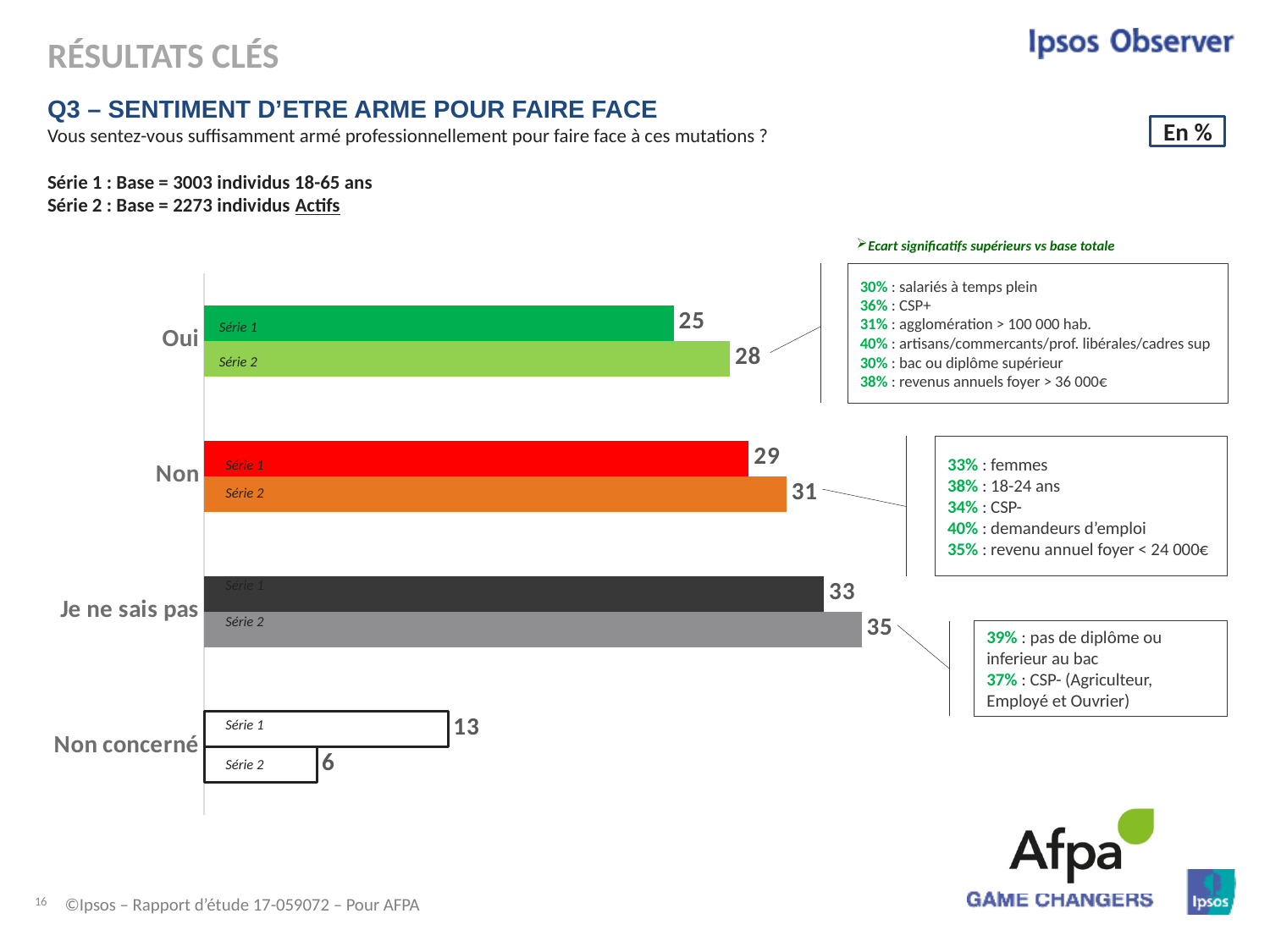
What is the value for Série 2 in the "Non concerné" category? 6 What is the value for Série 1 in the "Je ne sais pas" category? 33 What is the value for Série 2 in the "Non" category? 31 Which category has the lowest value for Série 1? Non concerné How many series are plotted in the chart? 2 What type of chart is shown on the slide? Bar chart Which category has the highest value for Série 2? Je ne sais pas How many response categories are shown in the chart? 4 What is the value for Série 1 in the "Oui" category? 25 What is the difference between Série 2 and Série 1 in the "Oui" category? 3 What is the difference between Série 1 and Série 2 in the "Non concerné" category? 7 Which is larger: Série 1 for "Non" or Série 2 for "Oui"? Série 1 for "Non"